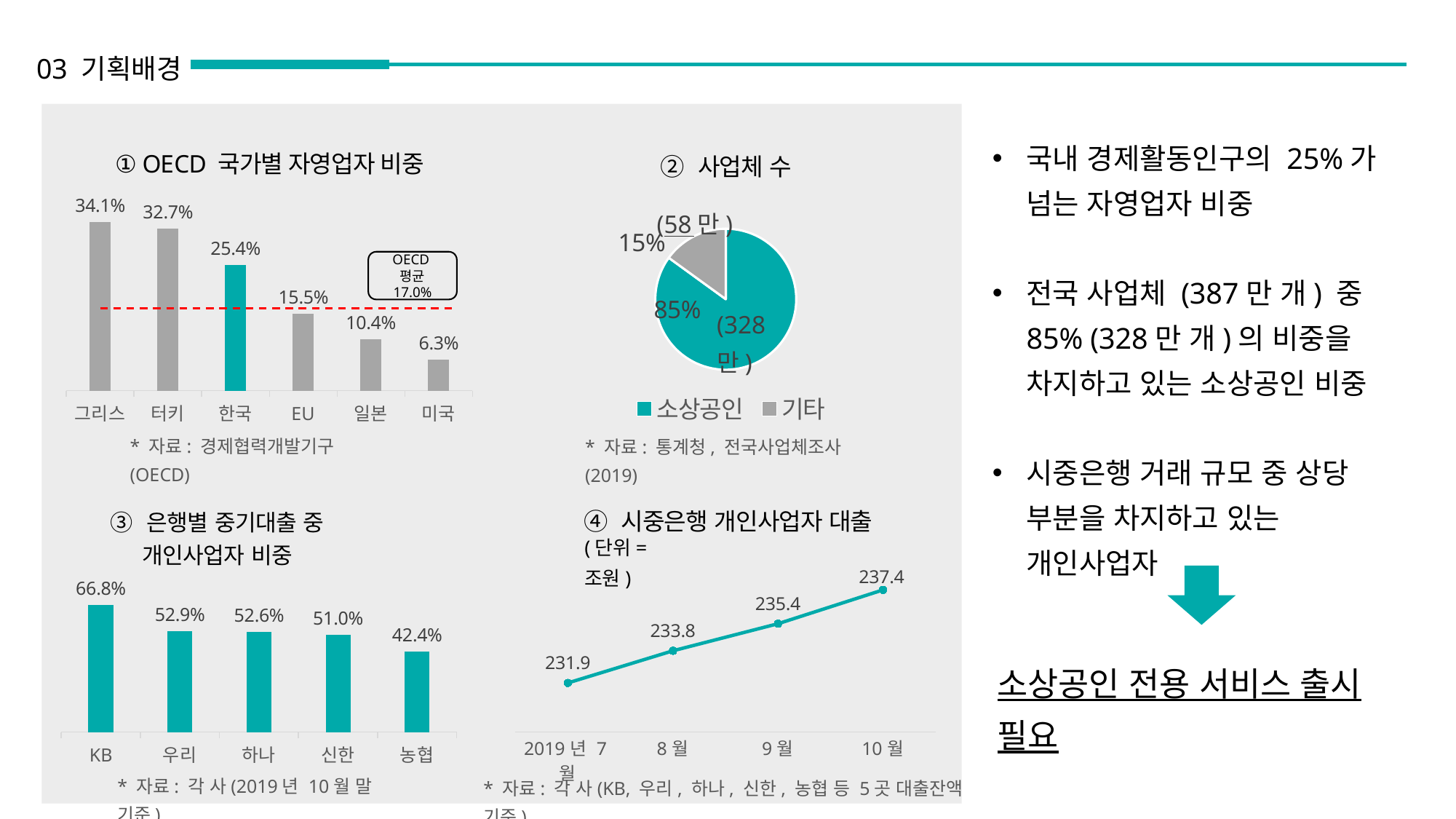
In the chart '① OECD 국가별 자영업자 비중', what is the value for 한국? 25.4% In the chart '③ 은행별 중기대출 중 개인사업자 비중', which bank has the highest value? KB In the chart '① OECD 국가별 자영업자 비중', which country has the highest value? 그리스 In the chart '② 사업체 수', what share of the pie is 소상공인? 85% In the chart '① OECD 국가별 자영업자 비중', what is the difference between 그리스 and 터키? 1.4% In the chart '② 사업체 수', how many series does the legend list? 2 In the chart '③ 은행별 중기대출 중 개인사업자 비중', how many banks are shown? 5 In the chart '③ 은행별 중기대출 중 개인사업자 비중', what is the value for 신한? 51.0% In the chart '① OECD 국가별 자영업자 비중', which category has the lowest value? 미국 In the chart '④ 시중은행 개인사업자 대출', what is the value for 10월? 237.4 In the chart '④ 시중은행 개인사업자 대출', do the values rise or fall from 2019년 7월 to 10월? rise In the chart '① OECD 국가별 자영업자 비중', what OECD average value is shown by the dashed line? 17.0%